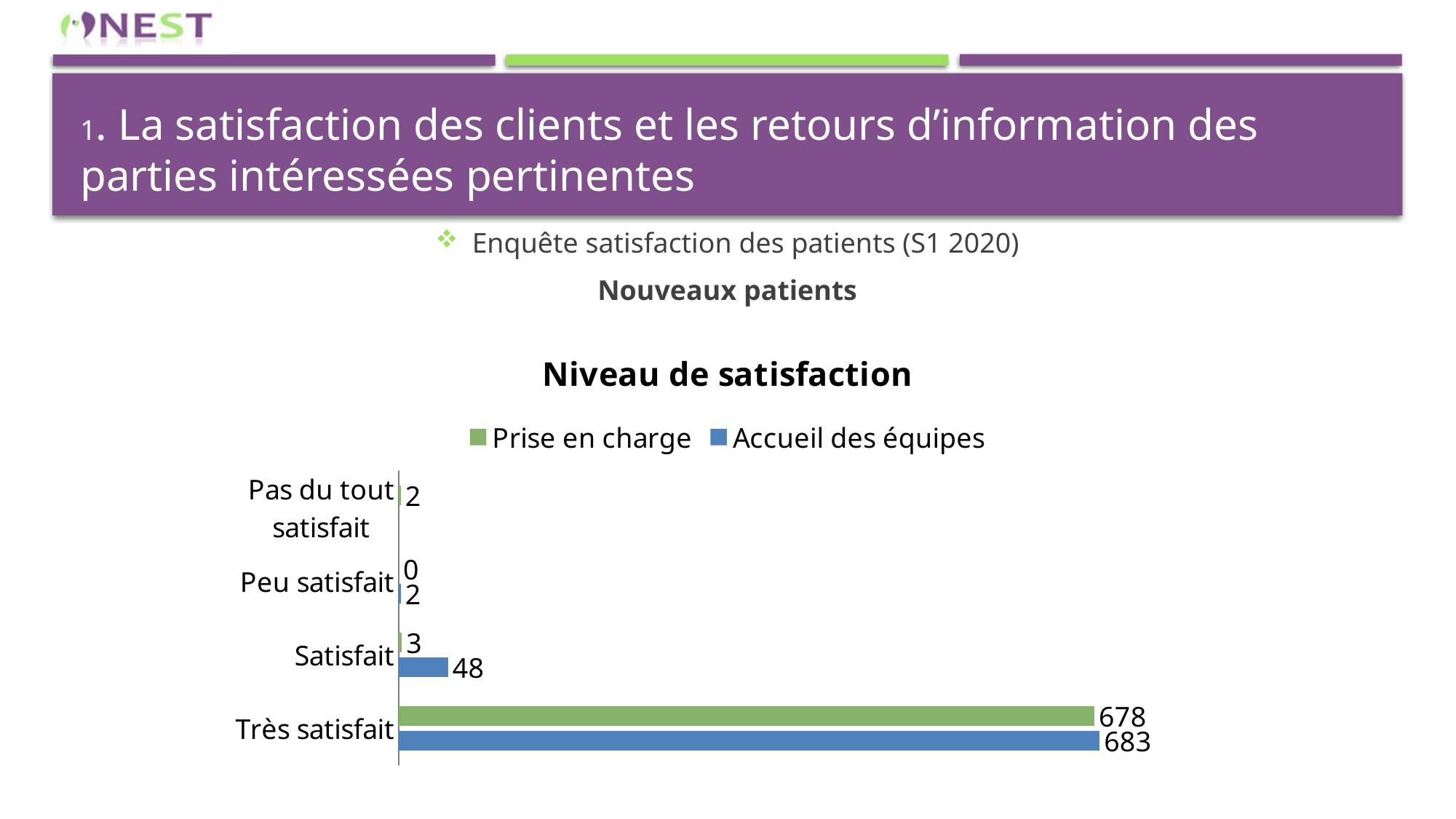
What type of chart is shown on the slide? bar chart Which category has the highest value for Accueil des équipes? Très satisfait What is the value for Accueil des équipes in the Satisfait category? 48 What is the value for Prise en charge in the Très satisfait category? 678 What is the value for Prise en charge in the Peu satisfait category? 0 What is the difference between Accueil des équipes and Prise en charge in the Très satisfait category? 5 In the Satisfait category, which series has the larger value, Prise en charge or Accueil des équipes? Accueil des équipes How many series does the legend list? 2 Which colour represents the Prise en charge series? green What is the value for Accueil des équipes in the Très satisfait category? 683 How many satisfaction categories are shown on the chart? 4 What is the chart's title? Niveau de satisfaction